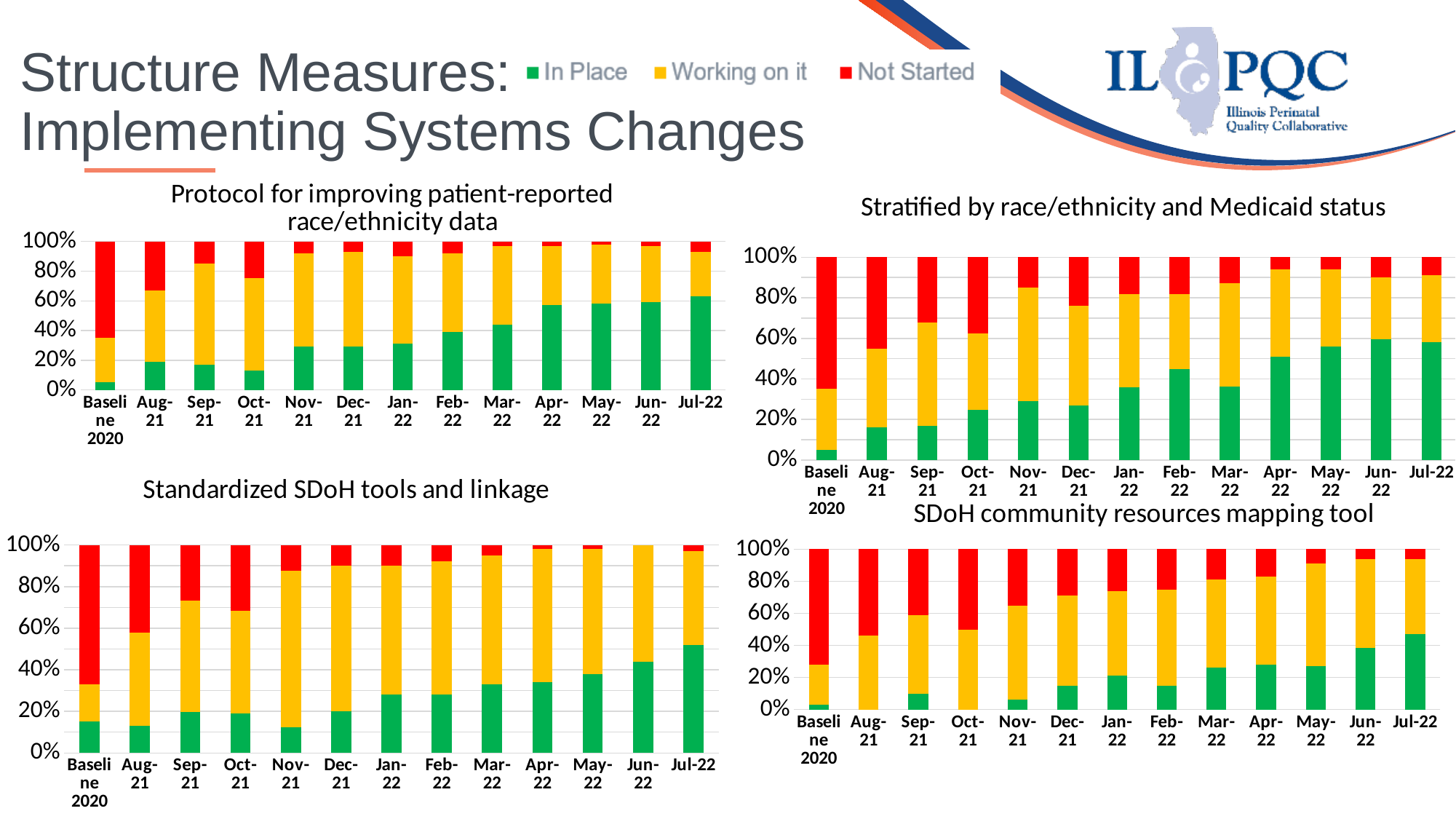
In the 'Standardized SDoH tools and linkage' chart, which category has the highest 'In Place' share? Jul-22 How many time-period categories are shown on the x axis of the 'Standardized SDoH tools and linkage' chart? 13 How many series does the legend at the top of the slide list? 3 In the 'Protocol for improving patient-reported race/ethnicity data' chart, which has the larger 'In Place' share, Mar-22 or Apr-22? Apr-22 In the 'Protocol for improving patient-reported race/ethnicity data' chart, which category has the lowest 'In Place' share? Baseline 2020 In the 'SDoH community resources mapping tool' chart, which category has the lowest 'In Place' share? Aug-21 and Oct-21 (both show no 'In Place' share) Which colour represents 'Not Started' in the legend? Red What kind of chart is the 'Protocol for improving patient-reported race/ethnicity data' chart? Stacked bar chart In the 'Protocol for improving patient-reported race/ethnicity data' chart, which category has the highest 'In Place' share? Jul-22 In the 'Stratified by race/ethnicity and Medicaid status' chart, is the 'In Place' value for Nov-21 greater or less than 20%? greater In the 'Protocol for improving patient-reported race/ethnicity data' chart, does the 'In Place' share generally rise or fall from Baseline 2020 to Jul-22? Rise In the 'Protocol for improving patient-reported race/ethnicity data' chart, is the 'In Place' value for Baseline 2020 greater or less than 20%? less